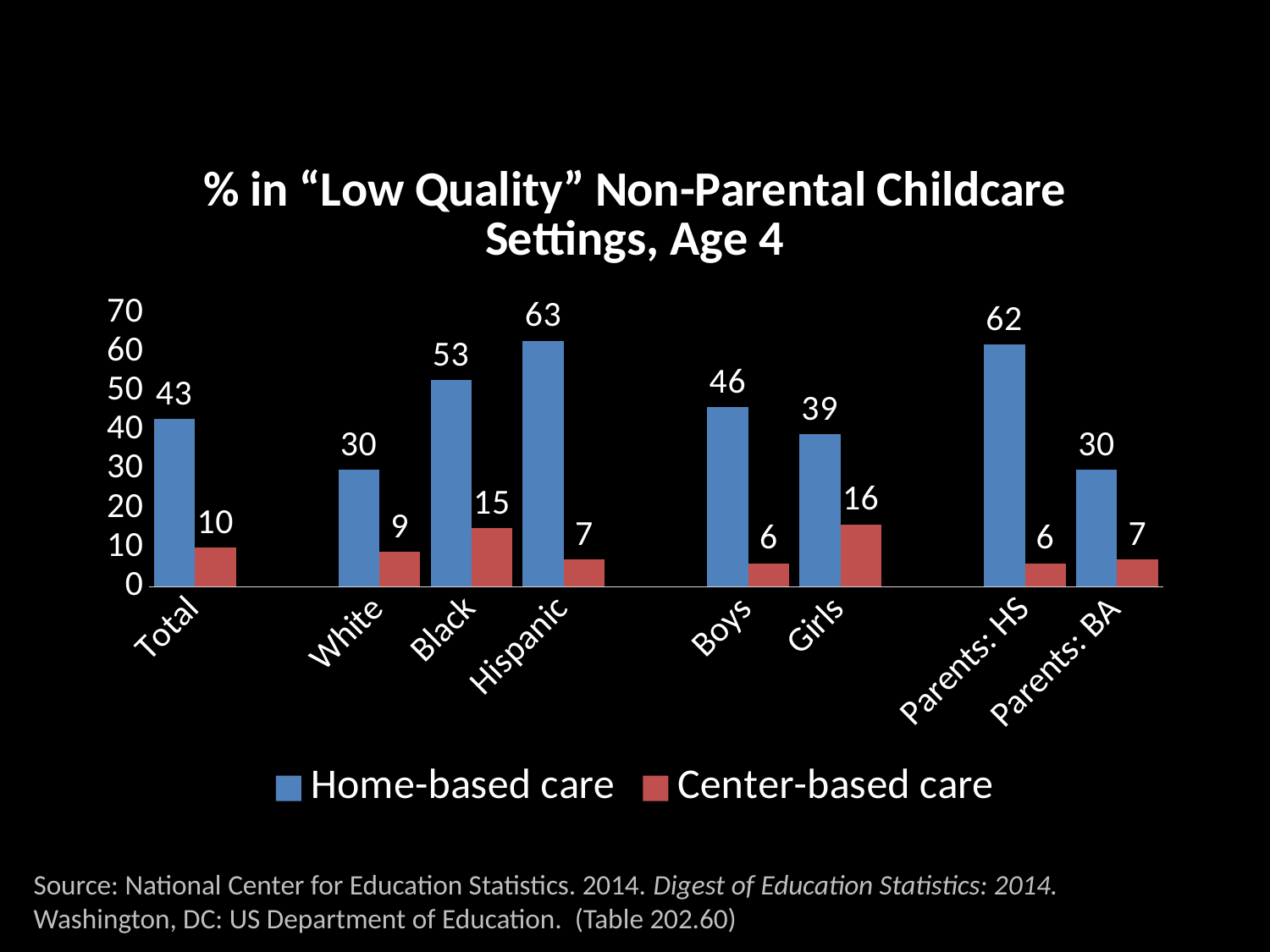
Which is larger, the Center-based care value for Black or for Girls? Girls What is the title of the chart? % in "Low Quality" Non-Parental Childcare Settings, Age 4 What is the difference between the Home-based care and Center-based care values for Total? 33 Which category has the lowest Home-based care value? White and Parents: BA (both 30) What is the difference between the Home-based care values for Parents: HS and Parents: BA? 32 How many series does the legend list? 2 Which category has the highest Home-based care value? Hispanic What is the Home-based care value for Hispanic? 63 What is the Center-based care value for Girls? 16 How many categories are shown on the x axis? 8 What kind of chart is shown on the slide? Bar chart What is the Home-based care value for Parents: BA? 30